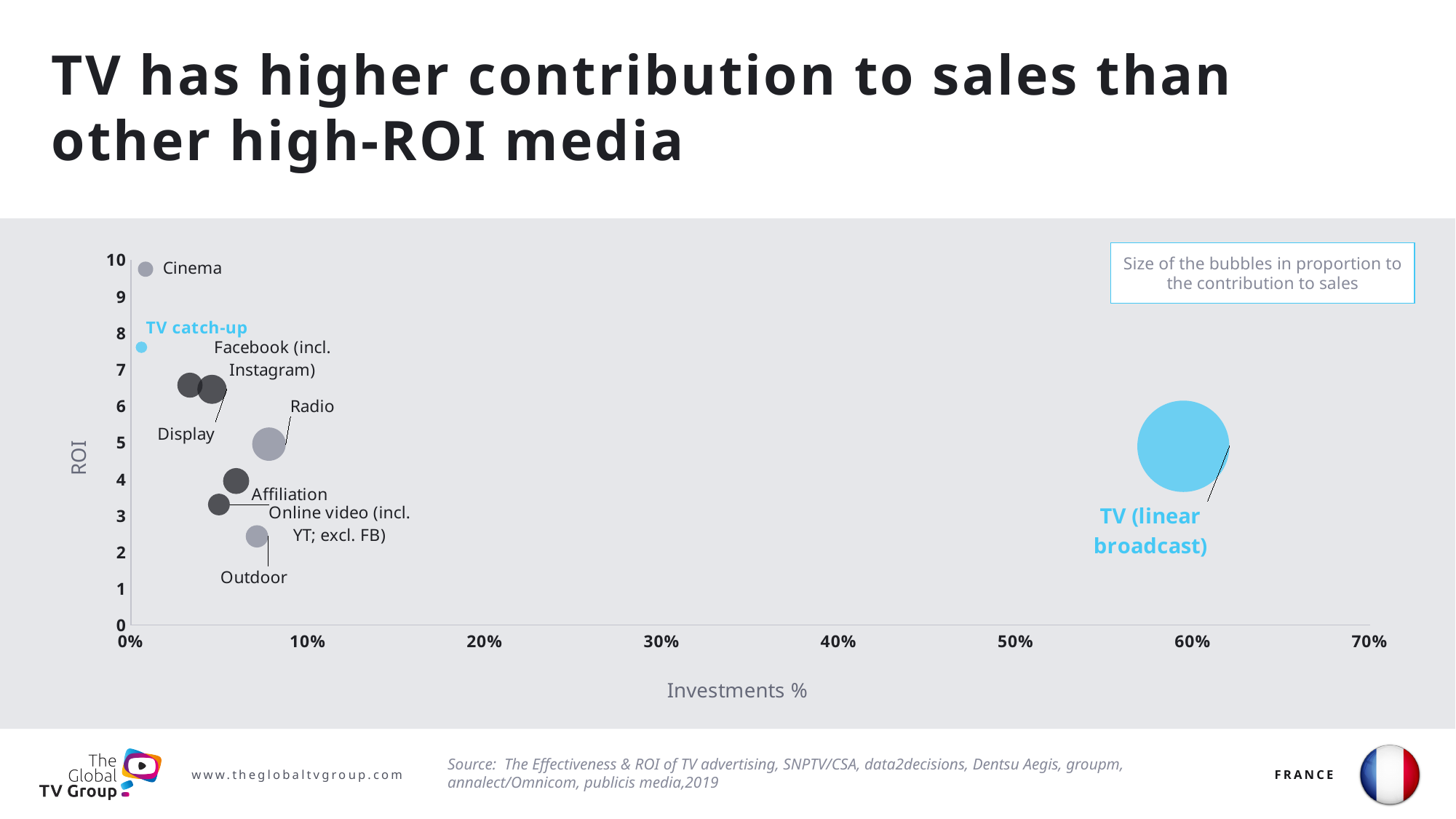
Is the ROI for Outdoor greater or less than 3? less What does the size of the bubbles represent on the chart? The contribution to sales Which media category has the lowest ROI on the chart? Outdoor What kind of chart is shown on the slide? Bubble chart Is the investments value for Radio greater or less than 10%? less How many media categories are plotted as bubbles on the chart? 9 Which media category has the highest share of investments on the chart? TV (linear broadcast) What is the label of the horizontal axis of the chart? Investments % Is the investments value for TV (linear broadcast) greater or less than 50%? greater Which has a higher ROI, Cinema or TV catch-up? Cinema Which media category has the highest ROI on the chart? Cinema